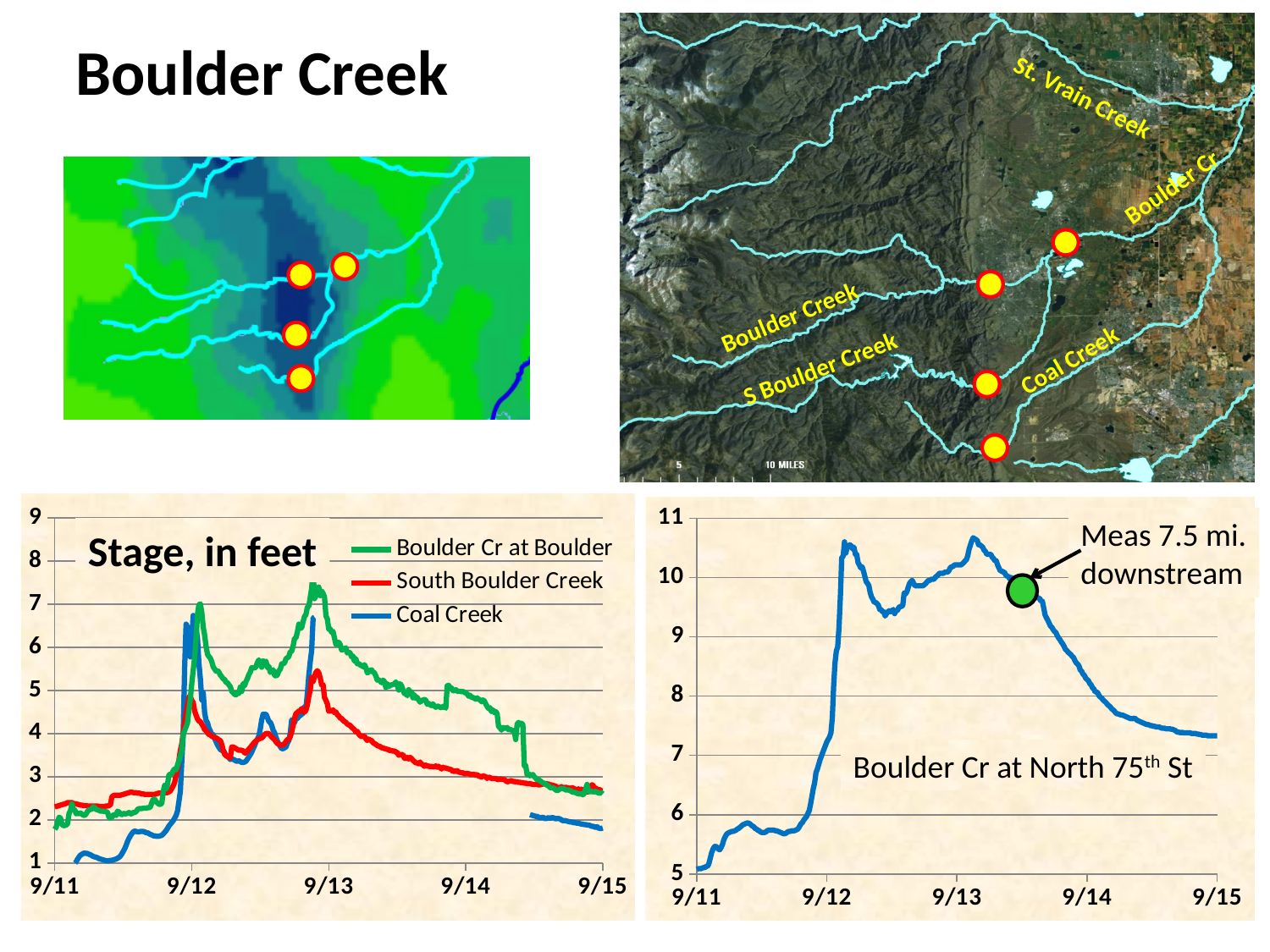
In the left chart ('Stage, in feet'), is the Coal Creek value at 9/11 greater or less than 2? less In the right chart ('Boulder Cr at North 75th St'), is the value at 9/15 greater or less than 8? less In the left chart ('Stage, in feet'), which series has the lowest value at 9/15? Coal Creek How many series does the legend of the left chart ('Stage, in feet') list? 3 What kind of chart is the left chart titled 'Stage, in feet'? line chart In the right chart ('Boulder Cr at North 75th St'), does the stage rise or fall between 9/14 and 9/15? fall What are the three series named in the legend of the left chart ('Stage, in feet')? Boulder Cr at Boulder, South Boulder Creek, Coal Creek In the right chart ('Boulder Cr at North 75th St'), is the peak value greater or less than 10? greater What is the title shown on the right chart? Boulder Cr at North 75th St In the left chart ('Stage, in feet'), which series reaches the highest peak stage? Boulder Cr at Boulder